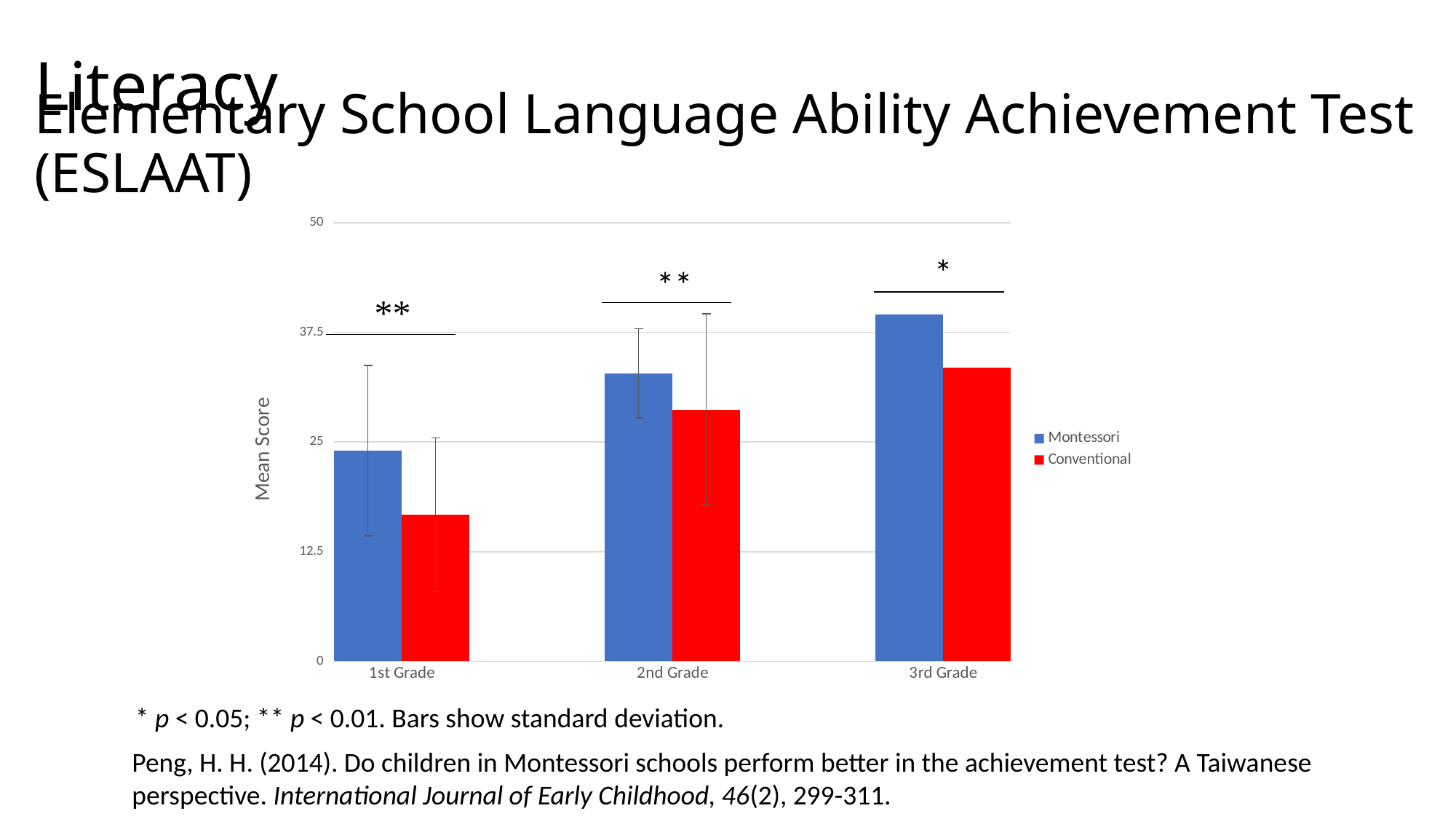
In 3rd Grade, which group has the higher mean score, Montessori or Conventional? Montessori Is the Montessori mean score for 2nd Grade greater or less than 37.5? less What kind of chart is shown on the slide? bar chart Which grade has the highest Montessori mean score? 3rd Grade Do the Montessori mean scores rise or fall from 1st Grade to 3rd Grade? rise Is the Montessori mean score for 3rd Grade greater or less than 37.5? greater How many series does the legend list? 2 In 1st Grade, which group has the higher mean score, Montessori or Conventional? Montessori Is the Conventional mean score for 1st Grade greater or less than 12.5? greater Which grade has the lowest Conventional mean score? 1st Grade How many grade categories are shown on the x axis? 3 What is the label on the y axis of the chart? Mean Score